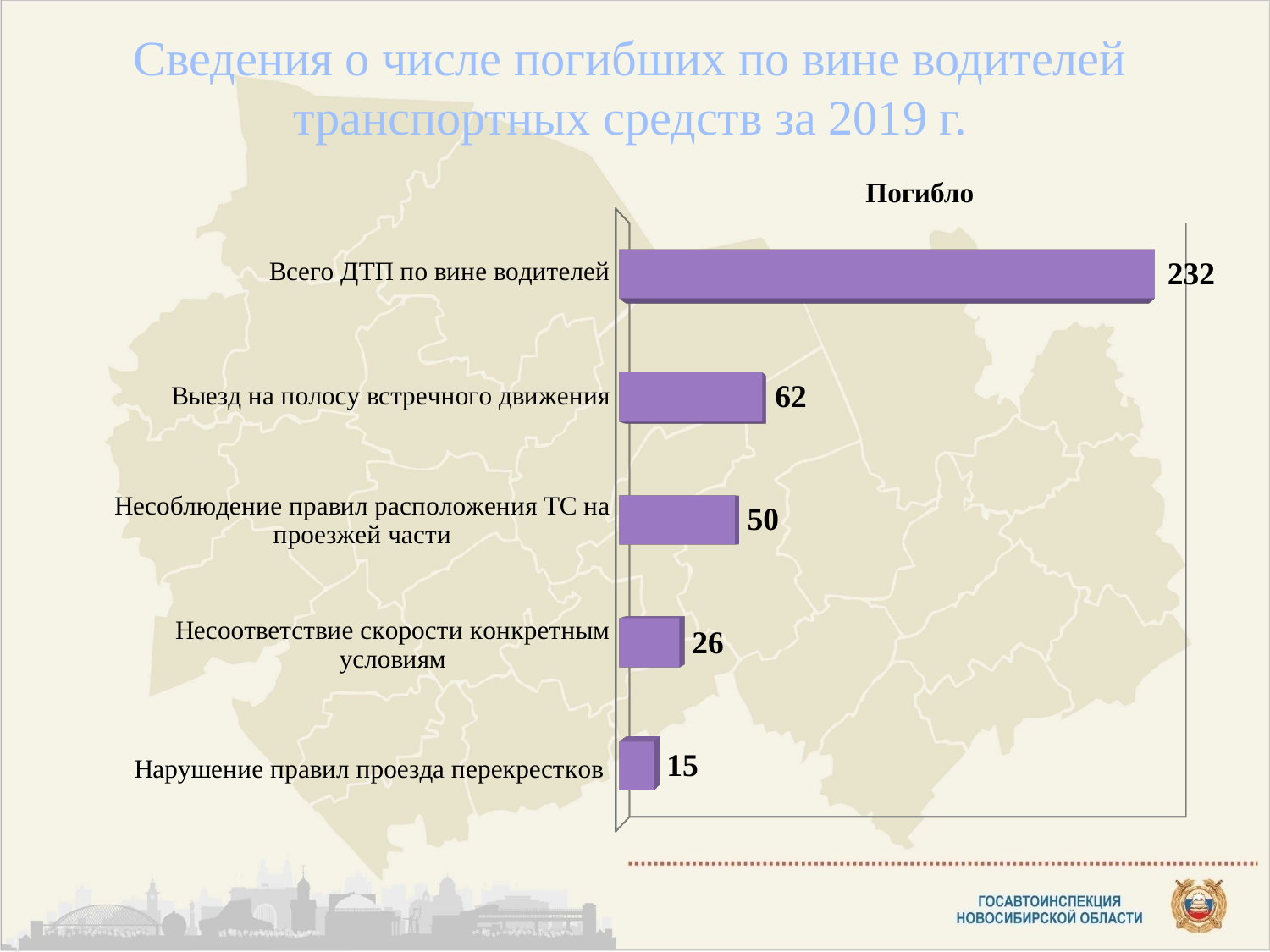
Which is larger: the value for "Несоблюдение правил расположения ТС на проезжей части" or for "Несоответствие скорости конкретным условиям"? Несоблюдение правил расположения ТС на проезжей части What is the difference between the values for "Выезд на полосу встречного движения" and "Несоблюдение правил расположения ТС на проезжей части"? 12 How many categories are shown in the chart? 5 What is the value for "Несоответствие скорости конкретным условиям"? 26 What colour are the bars in the chart? Purple What is the value for "Нарушение правил проезда перекрестков"? 15 Which category has the highest value? Всего ДТП по вине водителей What is the value for "Выезд на полосу встречного движения"? 62 What is the title of the chart? Погибло What is the value for "Всего ДТП по вине водителей"? 232 What kind of chart is shown on the slide? Bar chart Which category has the lowest value? Нарушение правил проезда перекрестков